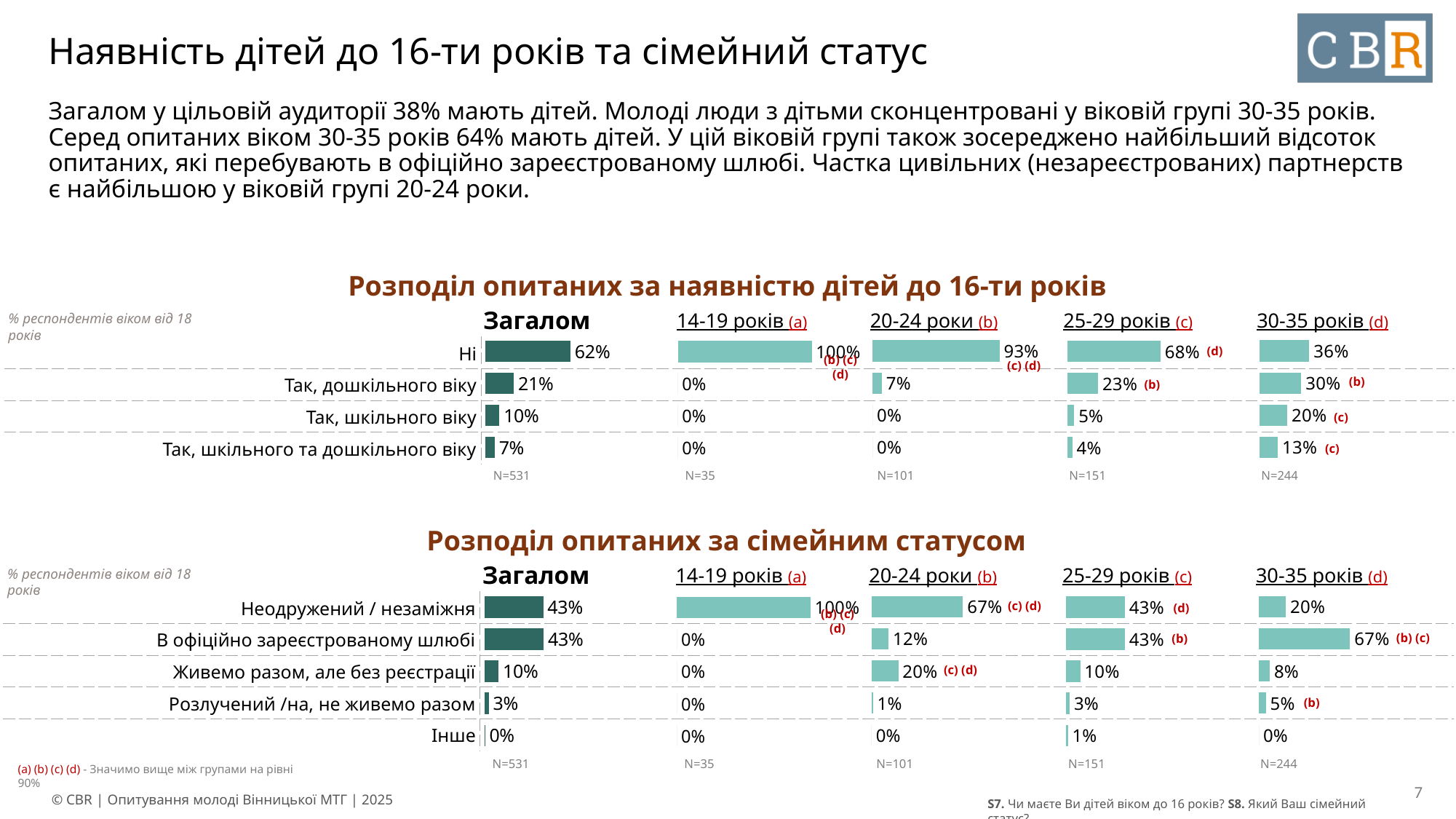
In the chart "Розподіл опитаних за сімейним статусом", what is the value for "В офіційно зареєстрованому шлюбі" in the "30-35 років" column? 67% In the chart "Розподіл опитаних за наявністю дітей до 16-ти років", what is the difference between the "Ні" values for "20-24 роки" and "25-29 років"? 25 percentage points What type of chart is used in "Розподіл опитаних за сімейним статусом"? Bar chart In the chart "Розподіл опитаних за наявністю дітей до 16-ти років", what is the value for "Ні" in the "Загалом" column? 62% How many answer categories are shown in the chart "Розподіл опитаних за наявністю дітей до 16-ти років"? 4 In the chart "Розподіл опитаних за сімейним статусом", what is the difference between the "Неодружений / незаміжня" values for "20-24 роки" and "30-35 років"? 47 percentage points In the chart "Розподіл опитаних за сімейним статусом", what is the sample size (N) shown for the "30-35 років" column? N=244 In the chart "Розподіл опитаних за наявністю дітей до 16-ти років", which age group has the highest value for "Ні"? 14-19 років In the chart "Розподіл опитаних за сімейним статусом", what is the value for "Живемо разом, але без реєстрації" in the "20-24 роки" column? 20% In the chart "Розподіл опитаних за сімейним статусом", which age group has the highest value for "Живемо разом, але без реєстрації"? 20-24 роки In the chart "Розподіл опитаних за наявністю дітей до 16-ти років", what is the value for "Так, дошкільного віку" in the "30-35 років" column? 30% In the chart "Розподіл опитаних за наявністю дітей до 16-ти років", which is larger for "Так, шкільного віку": "25-29 років" or "30-35 років"? 30-35 років